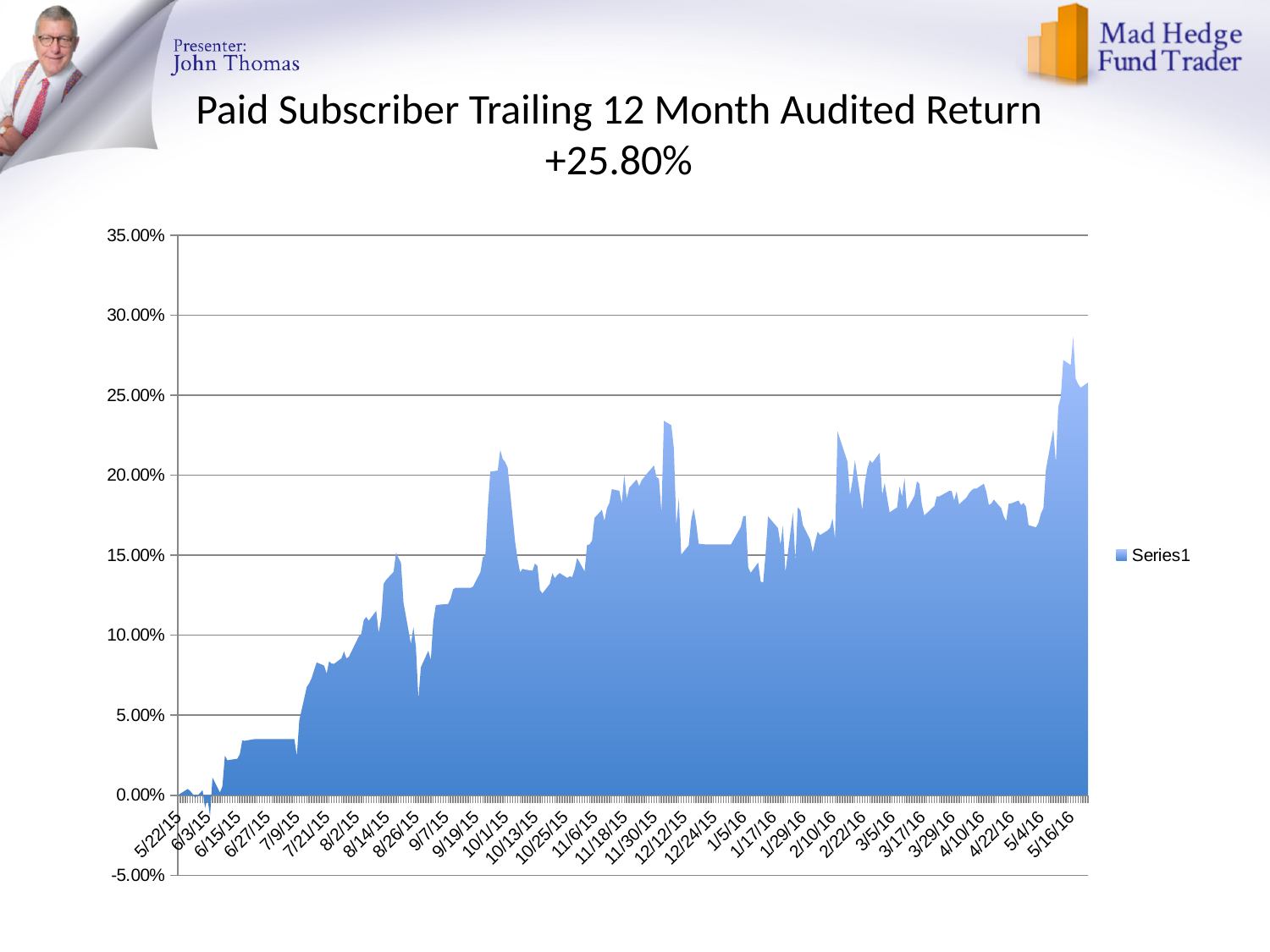
Is the value at 7/9/15 greater or less than 5.00%? less What is the legend entry for the plotted series? Series1 Is the value at 5/22/15 greater or less than 5.00%? less How many series does the legend list? 1 What kind of chart is shown on the slide? area chart Overall, do the values rise or fall from 5/22/15 to 5/16/16? rise Is the value at 5/16/16 greater or less than 20.00%? greater Which is larger, the value at 5/22/15 or the value at 5/16/16? 5/16/16 What return figure is stated in the chart title? +25.80%